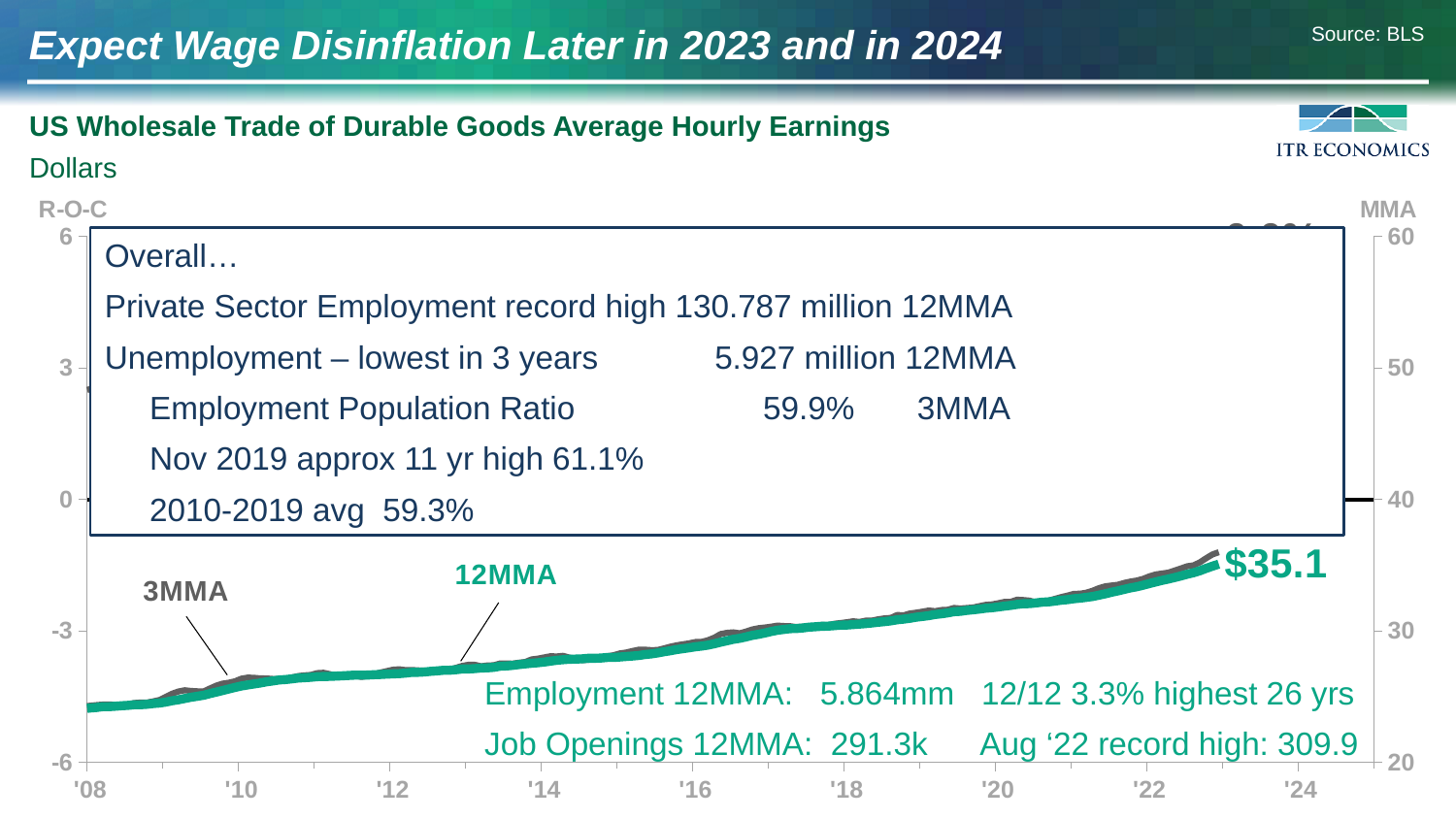
Is the 12MMA value at '08 greater or less than 30 on the right axis? less What is the title of the chart? US Wholesale Trade of Durable Goods Average Hourly Earnings What is the lowest value shown on the left (R-O-C) axis? -6 Which is larger, the 12MMA value at '20 or at '10? '20 In what units are the values on the chart expressed, according to the subtitle? Dollars What is the source cited for the chart data? BLS How many year labels are shown on the x axis? 9 What is the latest value labeled on the 12MMA line? $35.1 Is the 12MMA value at '22 greater or less than 30 on the right axis? greater What kind of chart is shown on the slide? line chart Does the 12MMA line rise or fall from '08 to '24? rises What is the highest value shown on the right (MMA) axis? 60